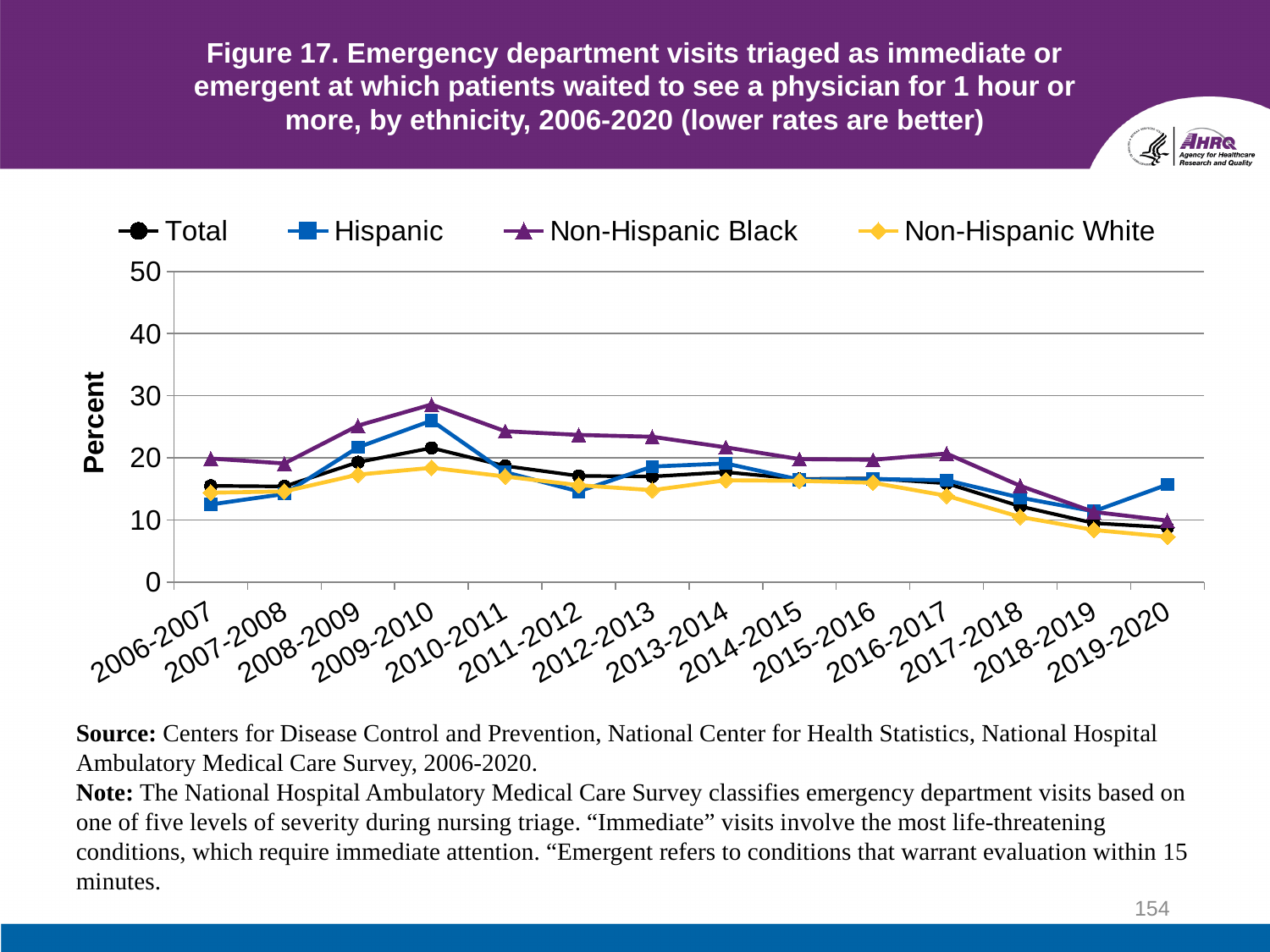
How many time periods are plotted along the x axis? 14 Which series has the highest value in 2009-2010? Non-Hispanic Black Does the Non-Hispanic Black series rise or fall from 2016-2017 to 2019-2020? Fall What is the label on the y axis? Percent Is the value for Non-Hispanic Black in 2009-2010 greater or less than 20? greater In 2019-2020, which is larger: the value for Hispanic or the value for Non-Hispanic White? Hispanic Is the value for Non-Hispanic White in 2019-2020 greater or less than 10? less What kind of chart is shown on the slide? Line chart In which period does the Non-Hispanic Black series reach its highest value? 2009-2010 How many series does the legend list? 4 Is the value for Hispanic in 2006-2007 greater or less than 20? less Which series has the lowest value in 2019-2020? Non-Hispanic White